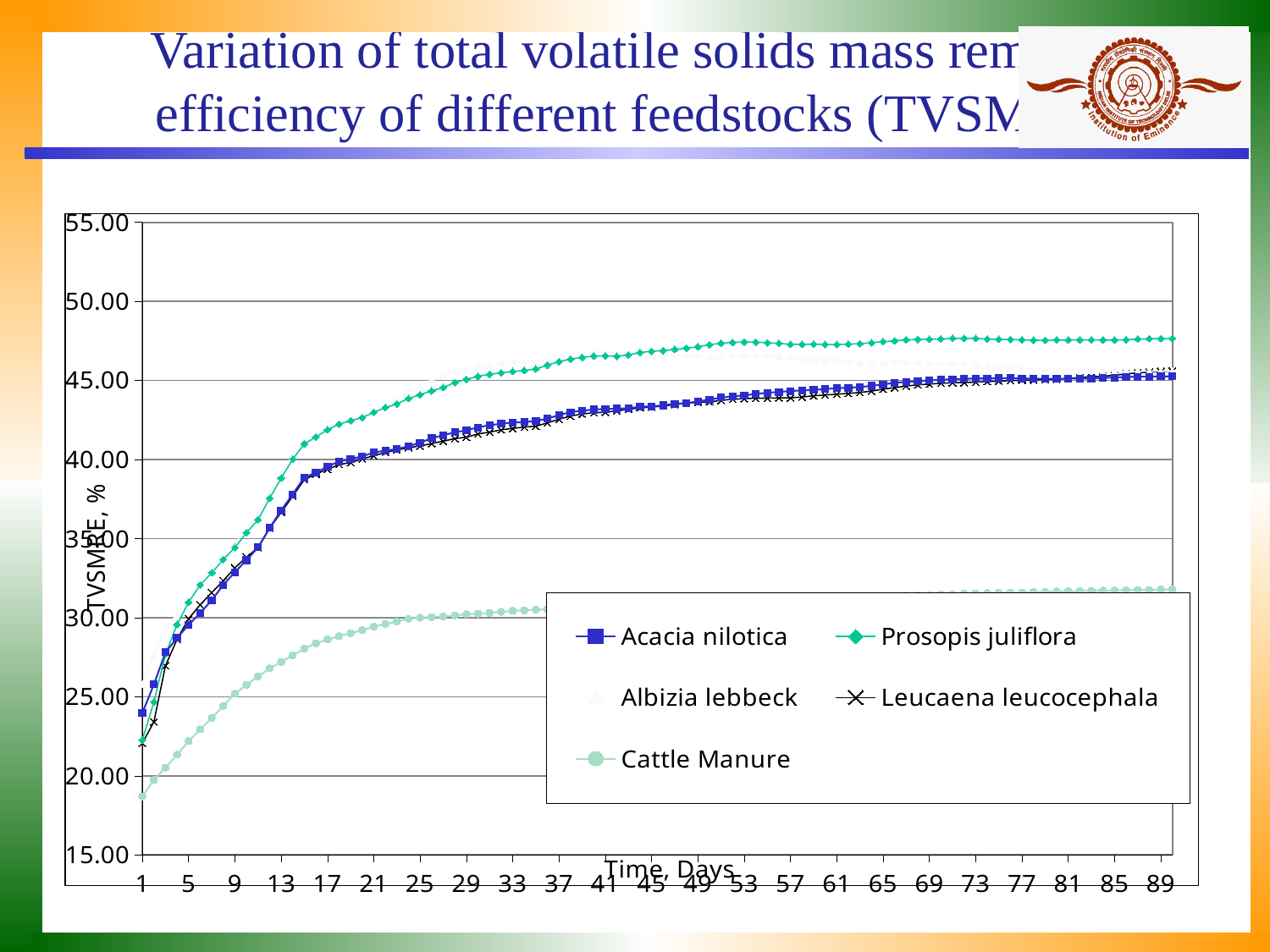
Is the value for Prosopis juliflora at day 1 greater or less than 25.00? less Is the value for Prosopis juliflora at day 89 greater or less than 45.00? greater How many series does the legend list? 5 Which feedstock has the lowest TVSMRE at day 89? Cattle Manure Is the value for Acacia nilotica at day 89 greater or less than 40.00? greater What kind of chart is shown on the slide? line chart Do the TVSMRE values for Cattle Manure rise or fall as time increases along the x axis? rise What is the label of the x axis? Time, Days Which feedstock has the highest TVSMRE at day 89? Prosopis juliflora At day 41, which is larger: the value for Prosopis juliflora or the value for Acacia nilotica? Prosopis juliflora